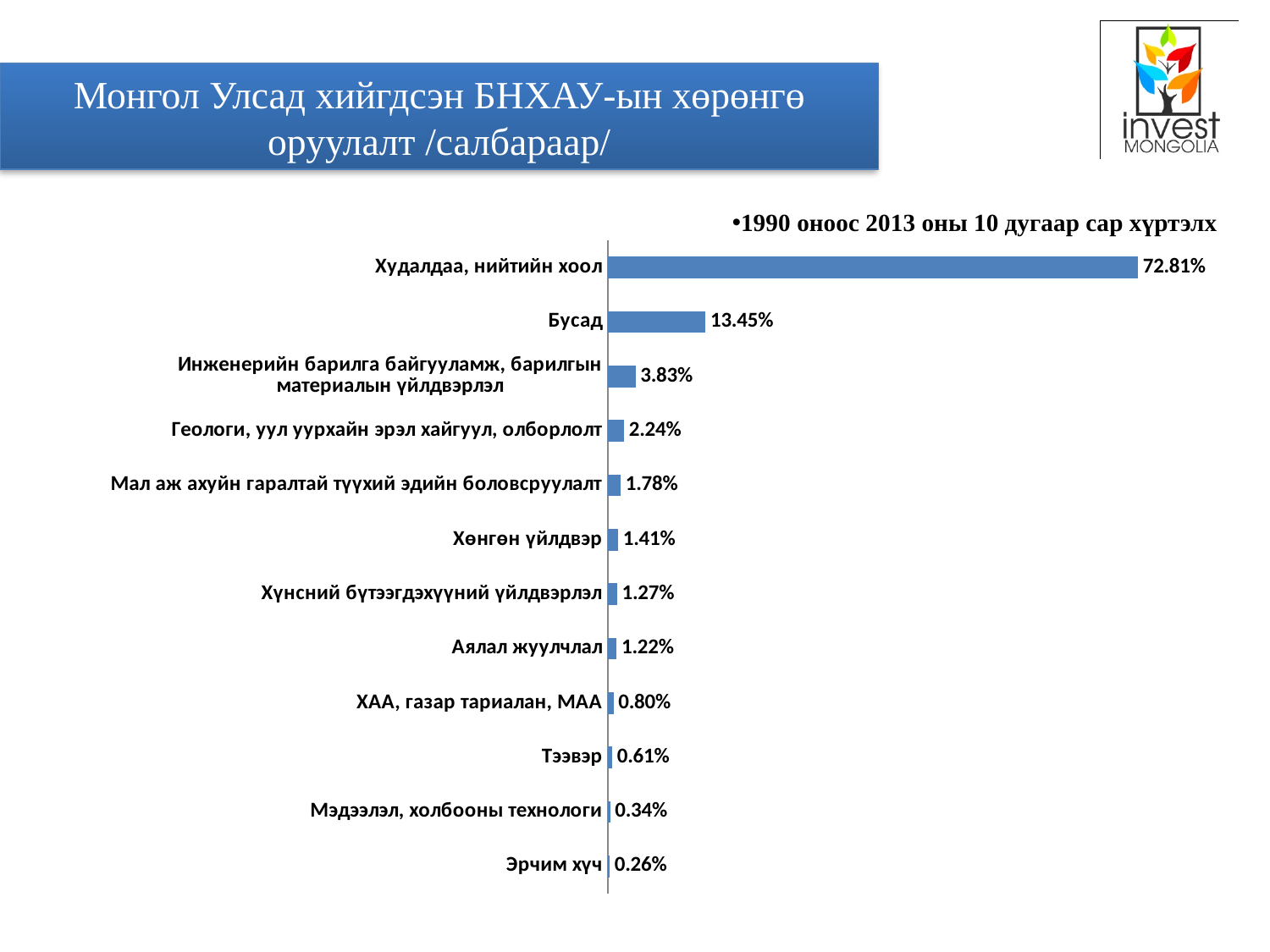
Which is larger, the value for Хөнгөн үйлдвэр or the value for Аялал жуулчлал? Хөнгөн үйлдвэр What is the value for Худалдаа, нийтийн хоол? 72.81% Which category has the highest value? Худалдаа, нийтийн хоол What is the difference between the values for Худалдаа, нийтийн хоол and Бусад? 59.36% Which category has the lowest value? Эрчим хүч What is the value for Геологи, уул уурхайн эрэл хайгуул, олборлолт? 2.24% What is the value for Тээвэр? 0.61% What is the difference between the values for Инженерийн барилга байгууламж, барилгын материалын үйлдвэрлэл and Геологи, уул уурхайн эрэл хайгуул, олборлолт? 1.59% What kind of chart is shown on the slide? Bar chart What period does the text above the chart say the data covers? 1990 оноос 2013 оны 10 дугаар сар хүртэлх How many categories are shown in the chart? 12 What is the value for Бусад? 13.45%